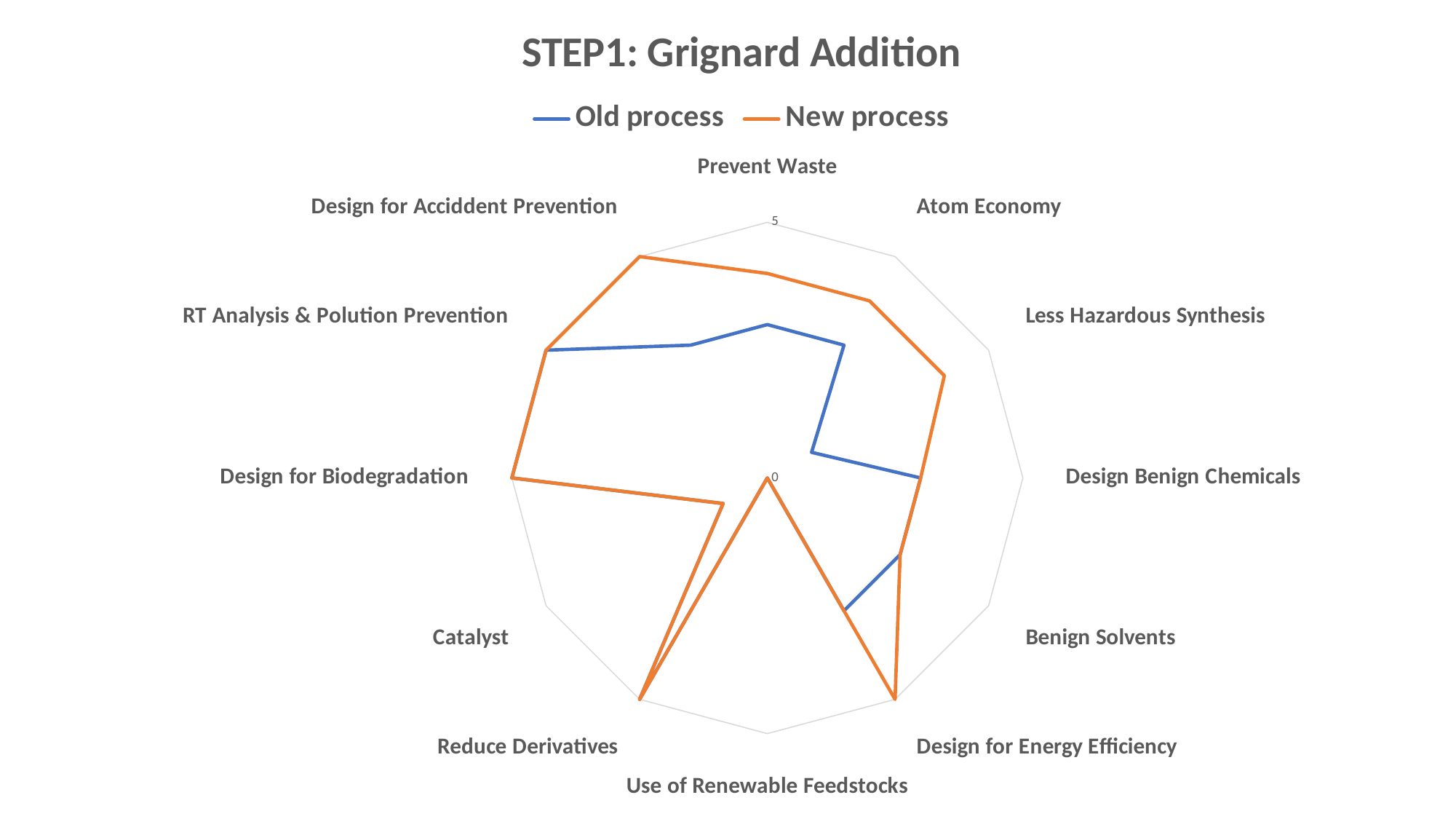
How many series does the legend list? 2 Which category has the lowest value for the New process? Use of Renewable Feedstocks What is the value for Design for Energy Efficiency for the New process? 5 For Design for Accident Prevention, which series has the larger value, Old process or New process? New process What is the value for Use of Renewable Feedstocks for the New process? 0 What is the value for Reduce Derivatives for the New process? 5 What is the title of the chart? STEP1: Grignard Addition For Less Hazardous Synthesis, which series has the larger value, Old process or New process? New process How many categories (axes) does the radar chart have? 12 What kind of chart is shown on the slide? Radar chart Is the Old process value for Prevent Waste greater or less than 5? less For Prevent Waste, which series has the larger value, Old process or New process? New process